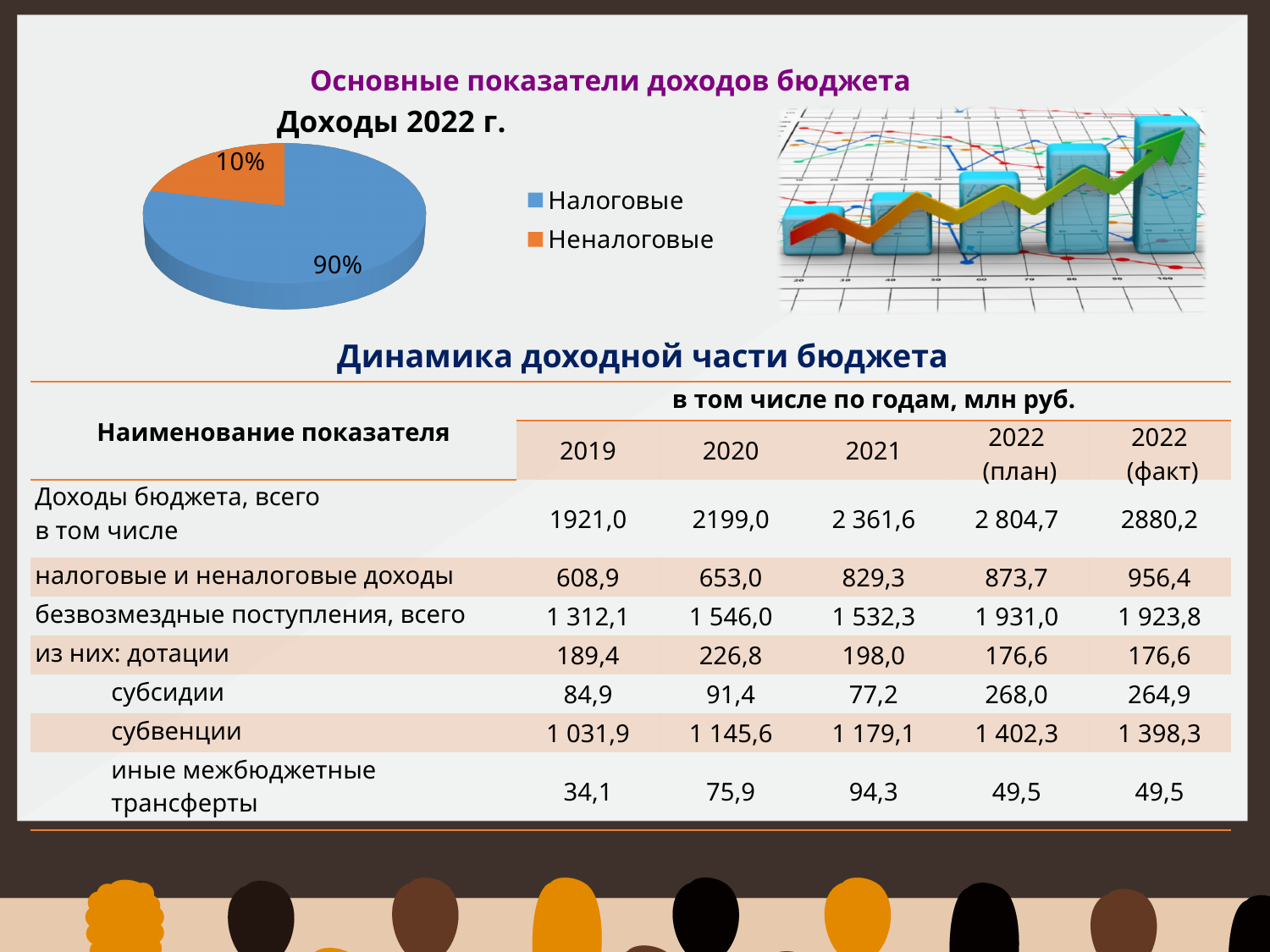
In the pie chart "Доходы 2022 г.", what share is labelled for Налоговые? 90% How many entries does the legend of the pie chart "Доходы 2022 г." list? 2 In the pie chart "Доходы 2022 г.", by how many percentage points does the Налоговые share exceed the Неналоговые share? 80 percentage points In the pie chart "Доходы 2022 г.", what share is labelled for Неналоговые? 10% What is the title of the pie chart on the slide? Доходы 2022 г. In the pie chart "Доходы 2022 г.", which is larger: the Налоговые slice or the Неналоговые slice? Налоговые What kind of chart is shown under the title "Доходы 2022 г."? pie chart In the pie chart "Доходы 2022 г.", which category has the largest slice? Налоговые In the pie chart "Доходы 2022 г.", how many slices does the pie have? 2 What colour is the Неналоговые slice in the pie chart "Доходы 2022 г."? orange In the pie chart "Доходы 2022 г.", which category has the smallest slice? Неналоговые